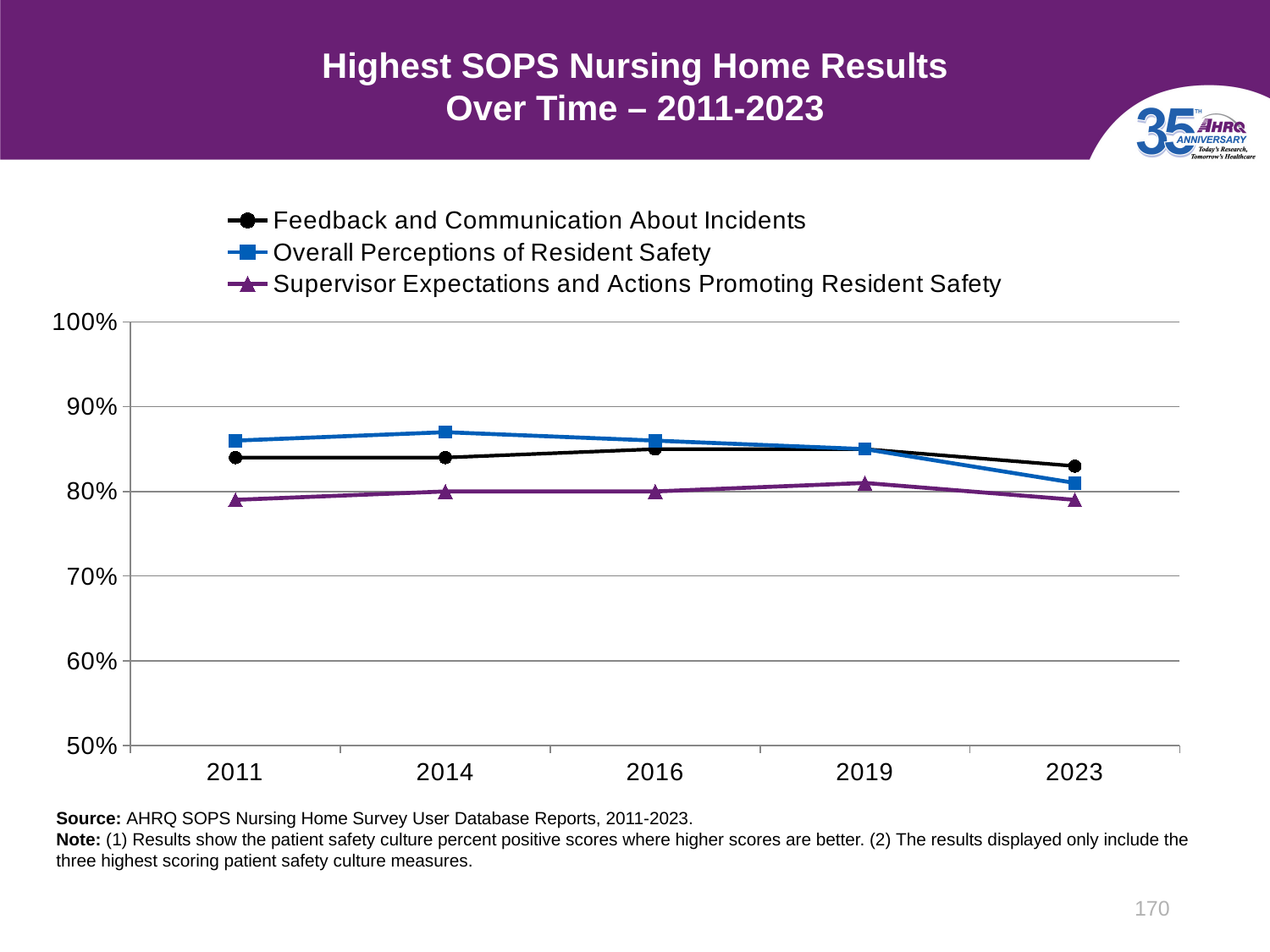
How many years are plotted along the x axis? 5 Is the value for Overall Perceptions of Resident Safety in 2014 greater or less than 80%? greater Does the value for Overall Perceptions of Resident Safety rise or fall from 2019 to 2023? fall Is the value for Feedback and Communication About Incidents in 2023 greater or less than 90%? less Which series has the lowest value in 2016? Supervisor Expectations and Actions Promoting Resident Safety Is the value for Supervisor Expectations and Actions Promoting Resident Safety in 2016 greater or less than 70%? greater What kind of chart is shown on the slide? Line chart Which series is plotted with purple triangle markers? Supervisor Expectations and Actions Promoting Resident Safety How many series does the legend list? 3 What is the title of the chart? Highest SOPS Nursing Home Results Over Time – 2011-2023 In 2011, which is higher: Overall Perceptions of Resident Safety or Feedback and Communication About Incidents? Overall Perceptions of Resident Safety In 2014, which is higher: Overall Perceptions of Resident Safety or Supervisor Expectations and Actions Promoting Resident Safety? Overall Perceptions of Resident Safety